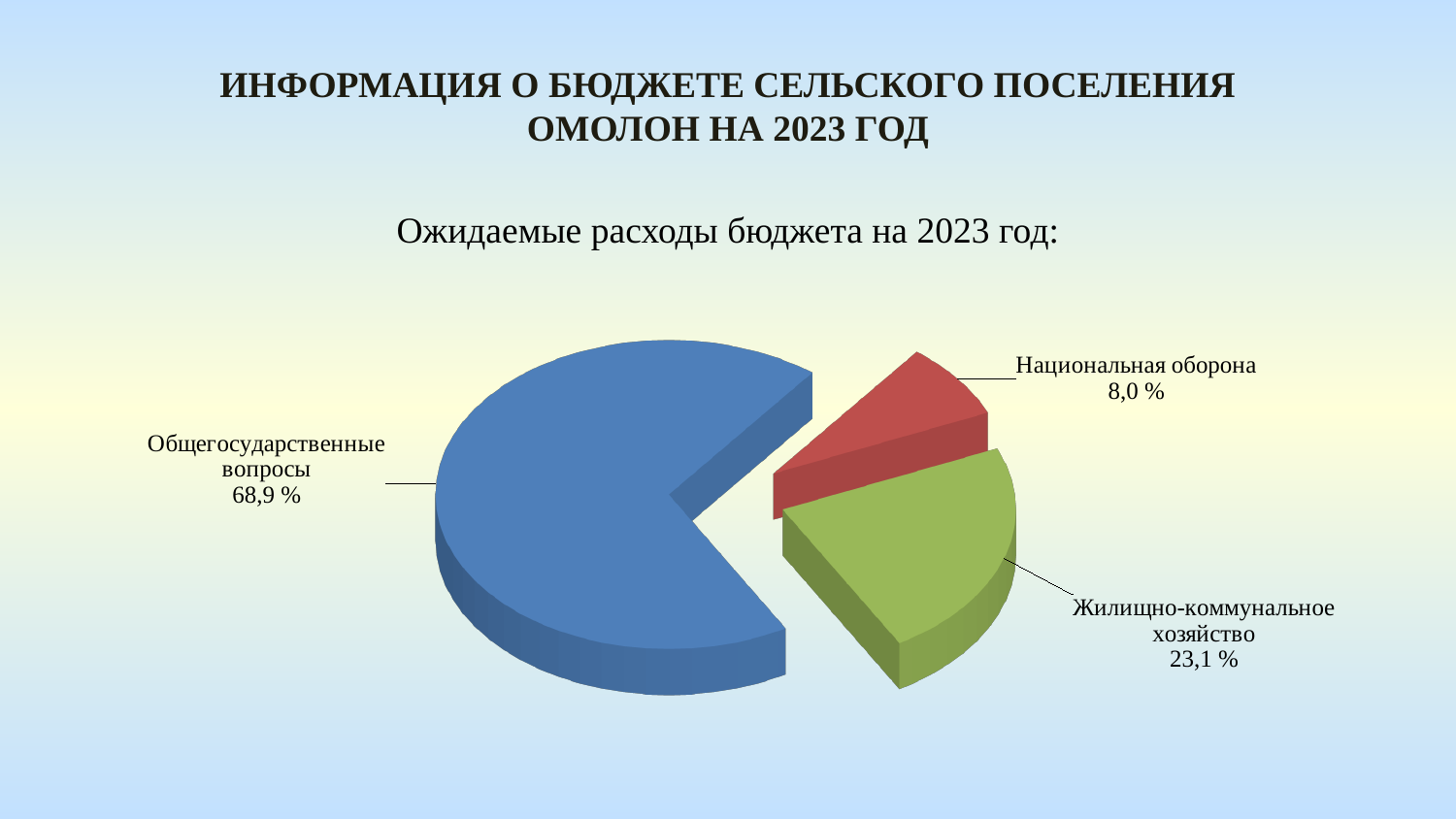
What share of expected 2023 budget expenditures goes to Национальная оборона? 8,0 % Which expenditure category has the largest share of the pie? Общегосударственные вопросы What is the difference in percentage points between the shares of Общегосударственные вопросы and Жилищно-коммунальное хозяйство? 45,8 What kind of chart is shown on the slide? Pie chart What is the difference in percentage points between the shares of Жилищно-коммунальное хозяйство and Национальная оборона? 15,1 What is the subtitle above the chart? Ожидаемые расходы бюджета на 2023 год: Which has a larger share: Жилищно-коммунальное хозяйство or Национальная оборона? Жилищно-коммунальное хозяйство How many categories are shown in the pie chart? 3 What colour is the slice for Общегосударственные вопросы? Blue What share of expected 2023 budget expenditures goes to Жилищно-коммунальное хозяйство? 23,1 % Which expenditure category has the smallest share of the pie? Национальная оборона What share of expected 2023 budget expenditures goes to Общегосударственные вопросы? 68,9 %